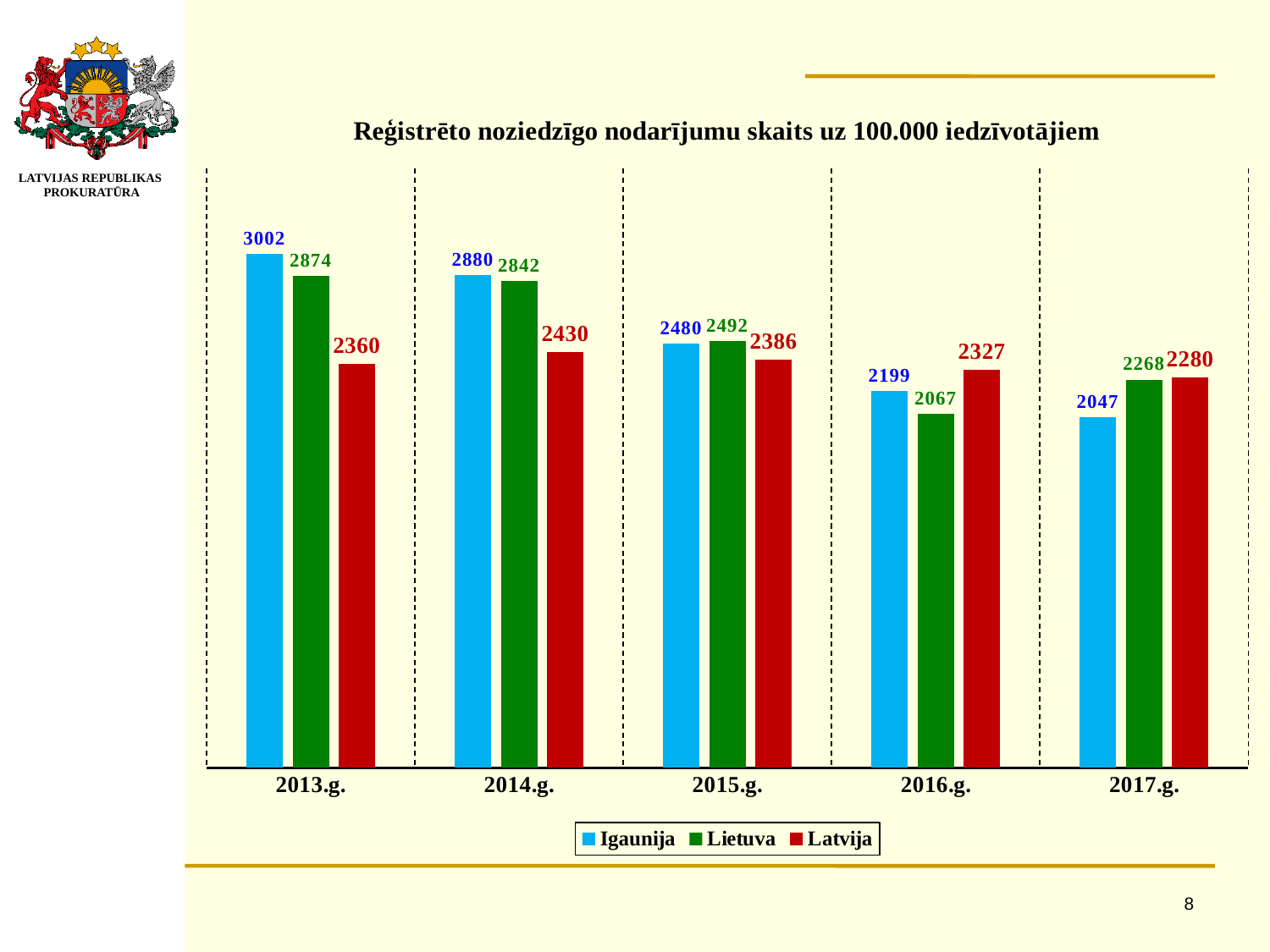
What kind of chart is shown on the slide? Bar chart How many series does the legend list? 3 What is the title of the chart? Reģistrēto noziedzīgo nodarījumu skaits uz 100.000 iedzīvotājiem What is the difference between the Igaunija and Latvija values in 2013.g.? 642 Which year has the highest value for Igaunija? 2013.g. Does the value for Igaunija rise or fall from 2013.g. to 2017.g.? Fall What is the value for Igaunija in 2013.g.? 3002 Which is larger in 2015.g., the value for Igaunija or for Lietuva? Lietuva What is the value for Latvija in 2016.g.? 2327 Which year has the lowest value for Lietuva? 2016.g. How many years are shown on the x axis? 5 What is the value for Lietuva in 2017.g.? 2268